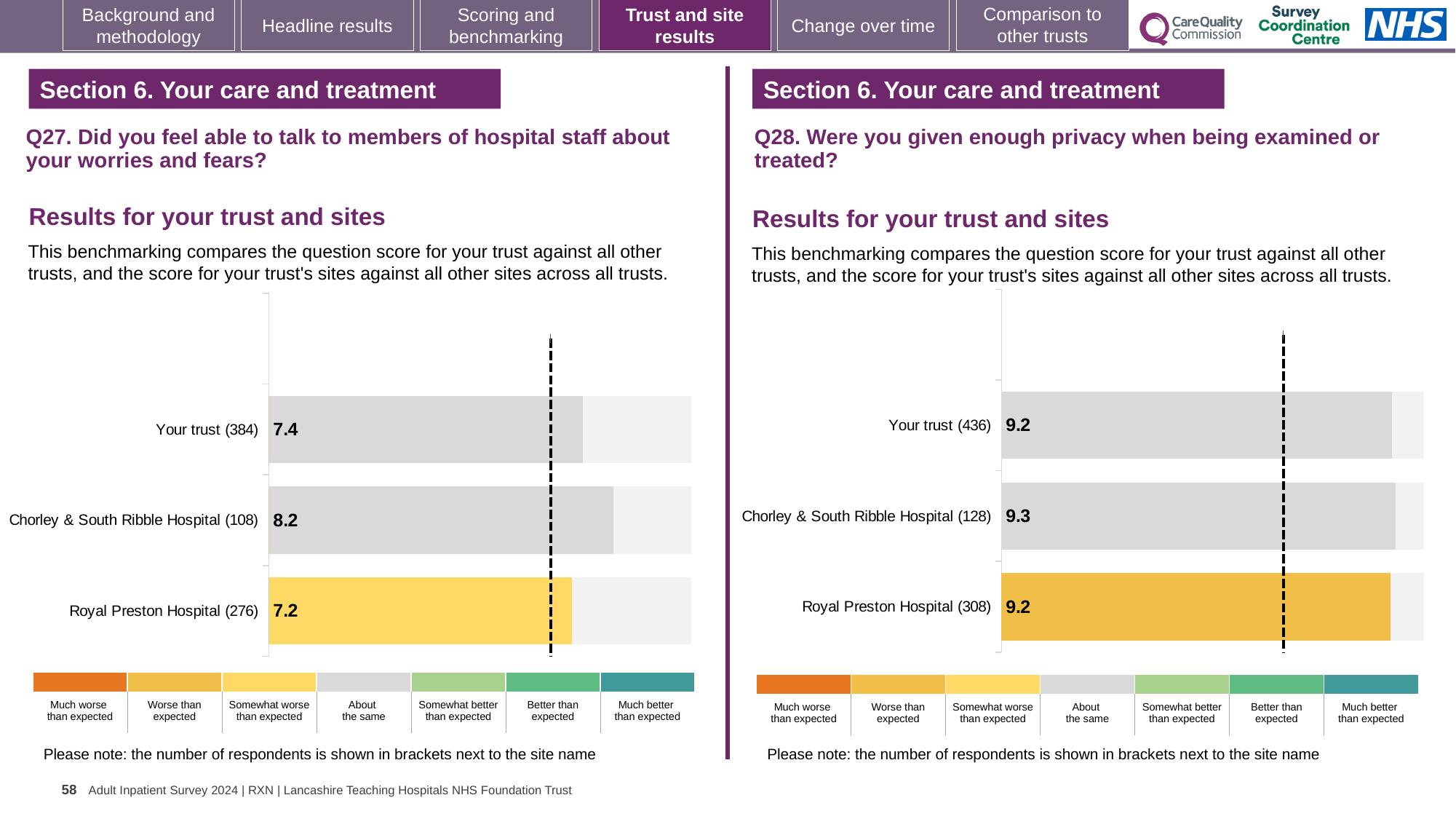
In the Q27 chart on the left, what is the score for Your trust? 7.4 In the Q27 chart on the left, what is the score for Chorley & South Ribble Hospital? 8.2 In the Q28 chart on the right, what is the score for Your trust? 9.2 In the Q28 chart on the right, how many respondents are shown in brackets for Your trust? 436 In the Q27 chart on the left, what is the score for Royal Preston Hospital? 7.2 In the Q27 chart on the left, which site or trust has the lowest score? Royal Preston Hospital How many bars are plotted in the Q28 chart on the right? 3 In the Q28 chart on the right, what is the score for Chorley & South Ribble Hospital? 9.3 In the Q27 chart on the left, what is the difference between the scores for Chorley & South Ribble Hospital and Royal Preston Hospital? 1.0 In the Q28 chart on the right, what is the score for Royal Preston Hospital? 9.2 In the Q27 chart on the left, which site or trust has the highest score? Chorley & South Ribble Hospital What kind of chart is used in the Q27 chart on the left? Bar chart